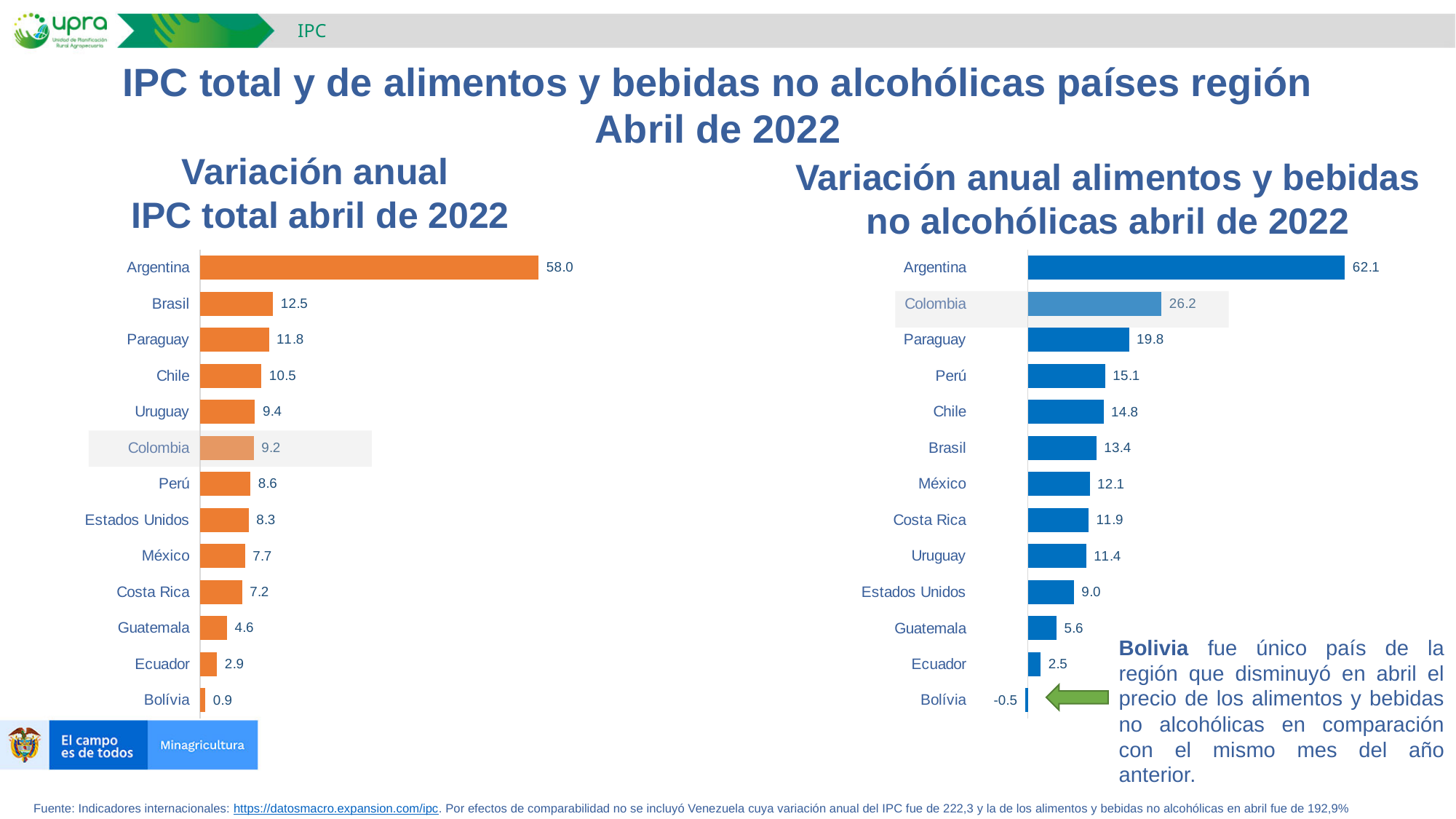
In the 'Variación anual alimentos y bebidas no alcohólicas abril de 2022' chart, what is the difference between the values for Argentina and Colombia? 35.9 What kind of chart is the 'Variación anual alimentos y bebidas no alcohólicas abril de 2022' chart? Bar chart In the 'Variación anual alimentos y bebidas no alcohólicas abril de 2022' chart, what is the value for Perú? 15.1 In the 'Variación anual alimentos y bebidas no alcohólicas abril de 2022' chart, what is the value for Bolívia? -0.5 How many countries are shown in the 'Variación anual IPC total abril de 2022' chart? 13 In the 'Variación anual IPC total abril de 2022' chart, what is the difference between the values for Brasil and Paraguay? 0.7 In the 'Variación anual alimentos y bebidas no alcohólicas abril de 2022' chart, which country has the lowest value? Bolívia In the 'Variación anual IPC total abril de 2022' chart, what is the value for Colombia? 9.2 In the 'Variación anual IPC total abril de 2022' chart, which is larger, the value for Chile or the value for Uruguay? Chile In the 'Variación anual alimentos y bebidas no alcohólicas abril de 2022' chart, which is larger, the value for Costa Rica or the value for Uruguay? Costa Rica What colour are the bars in the 'Variación anual IPC total abril de 2022' chart? Orange In the 'Variación anual IPC total abril de 2022' chart, which country has the highest value? Argentina